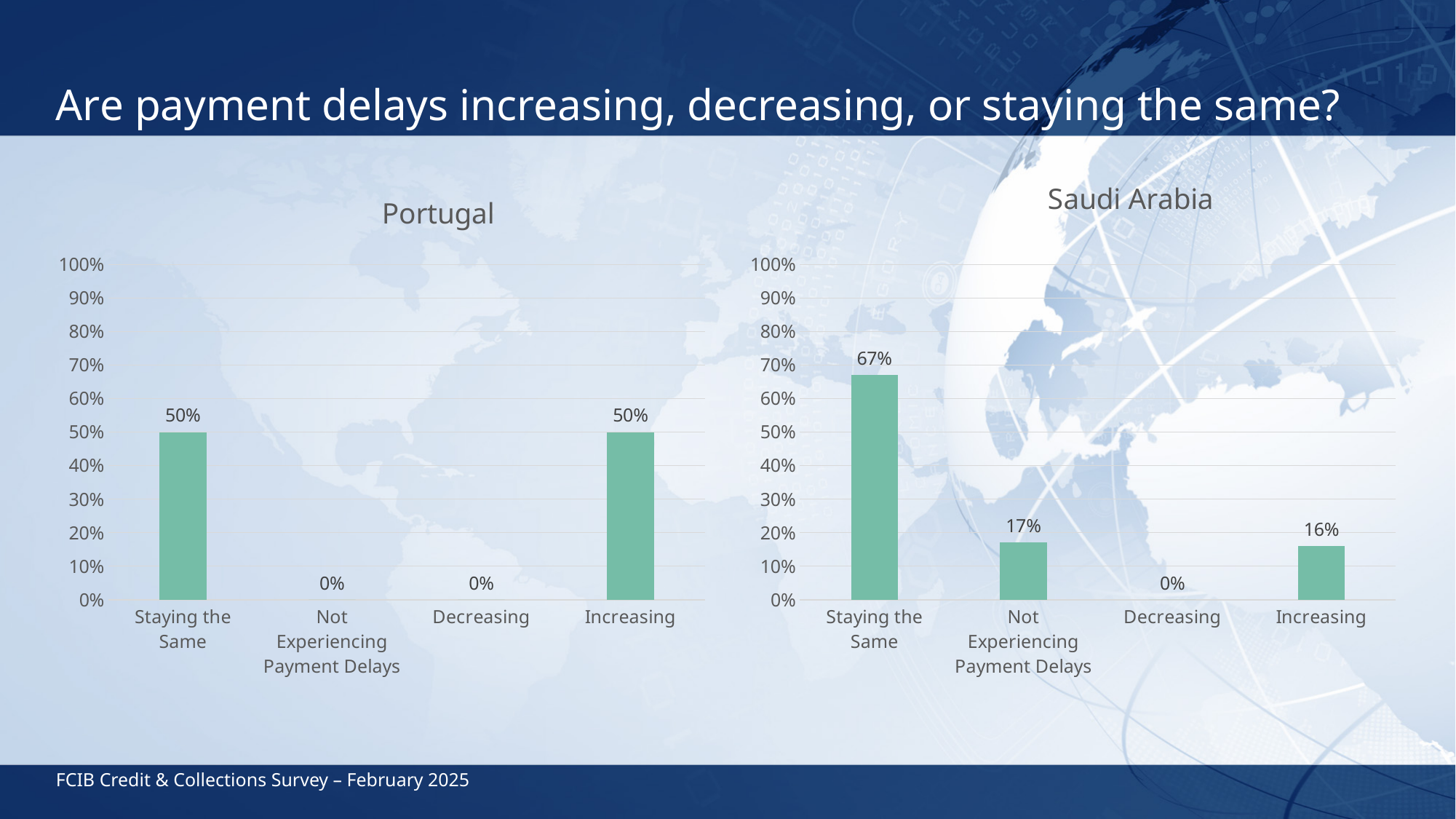
In the Saudi Arabia chart, which category has the lowest value? Decreasing In the Saudi Arabia chart, which category has the highest value? Staying the Same In the Portugal chart, what is the value for Decreasing? 0% In the Saudi Arabia chart, what is the value for Increasing? 16% How many categories are shown in the Portugal chart? 4 Which is larger: Staying the Same in the Portugal chart or Staying the Same in the Saudi Arabia chart? Saudi Arabia In the Saudi Arabia chart, what is the value for Staying the Same? 67% In the Saudi Arabia chart, what is the value for Not Experiencing Payment Delays? 17% In the Saudi Arabia chart, what is the difference between Staying the Same and Increasing? 51% What kind of chart is the Portugal chart? Bar chart In the Portugal chart, what is the value for Staying the Same? 50% In the Saudi Arabia chart, is the value for Staying the Same greater or less than 60%? greater